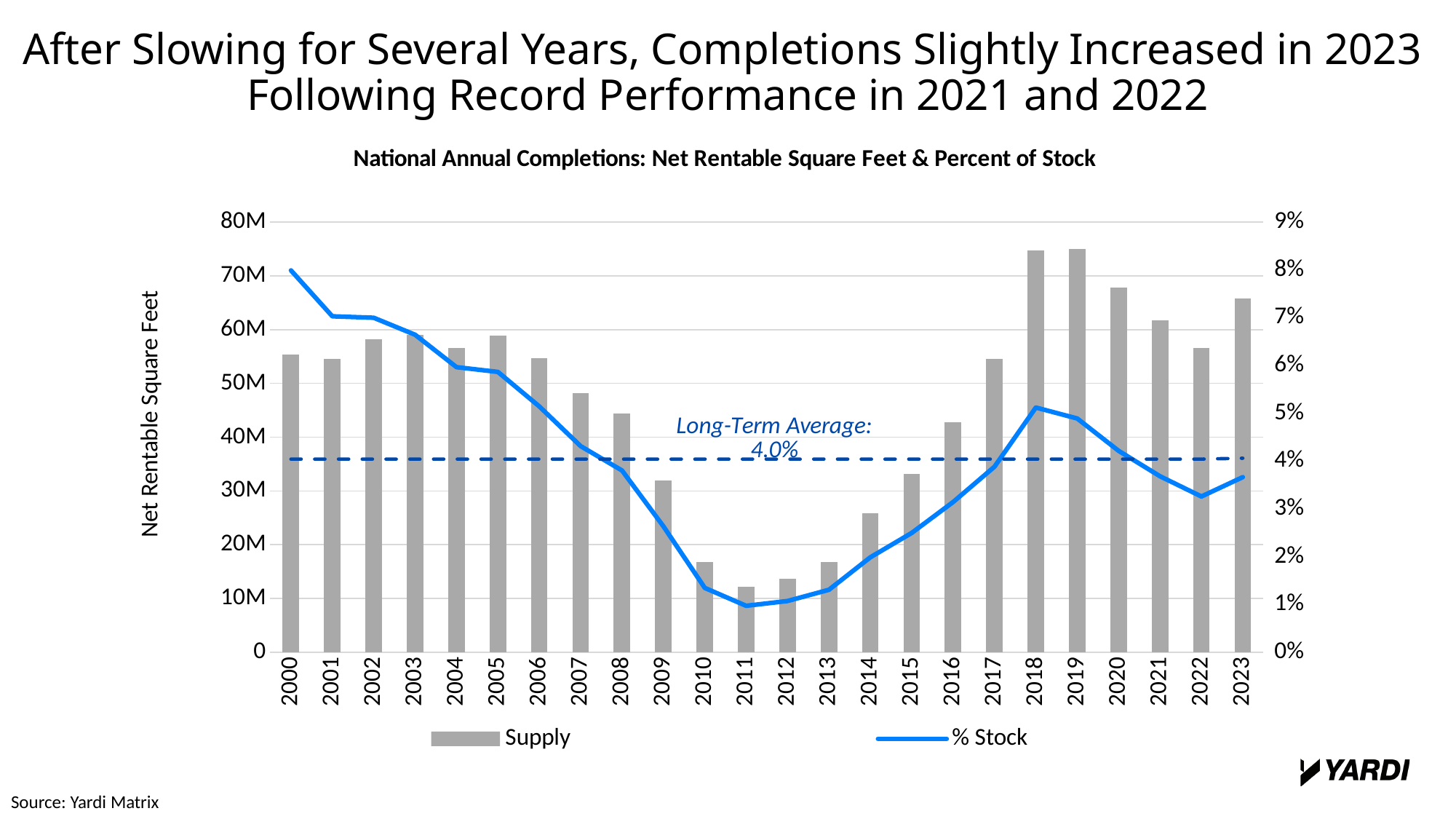
Is the Supply value for 2000 greater or less than 50M? greater Is the % Stock value for 2000 greater or less than 7%? greater Does the % Stock line rise or fall from 2000 to 2011? fall How many years are shown on the x axis of the chart? 24 How many series does the legend list? 2 Is the % Stock value for 2011 greater or less than 2%? less What kind of chart is this? Combination bar and line chart What is the long-term average percent of stock shown by the dashed line? 4.0% Which year has the larger Supply value, 2000 or 2010? 2000 Which series is shown as a blue line in the legend? % Stock